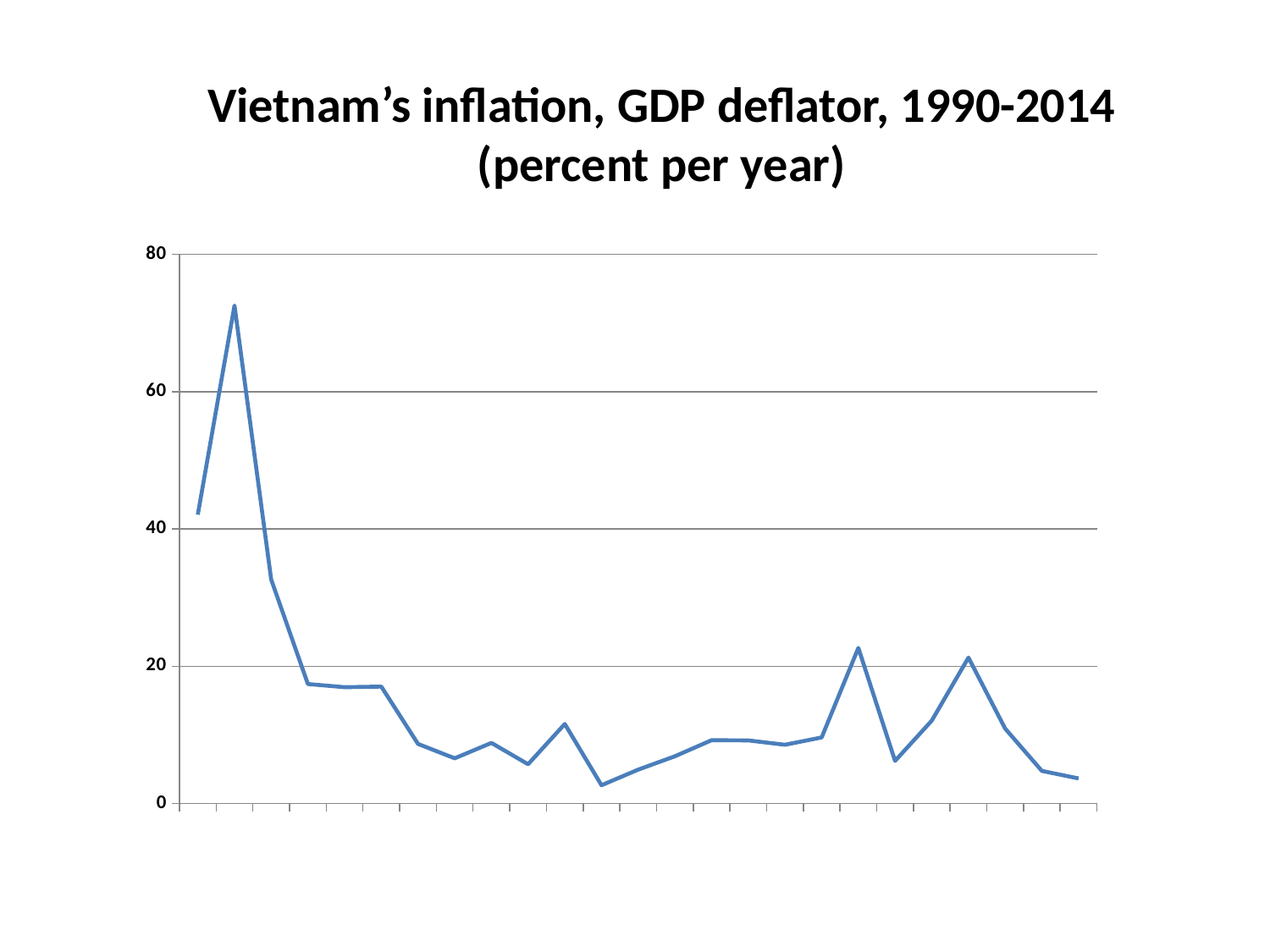
Is the lowest point on the line greater or less than 20? less Is the highest point on the line greater or less than 60? greater Is the third point from the left greater or less than 40? less What kind of chart is shown on the slide? line chart Overall, do the values rise or fall from the left of the chart to the right? fall Does the line rise or fall between the first and second points from the left? rise What is the highest value shown on the vertical axis? 80 What is the title of the chart? Vietnam's inflation, GDP deflator, 1990-2014 (percent per year) Is the peak near the start of the series higher or lower than the peaks in the right half of the chart? higher